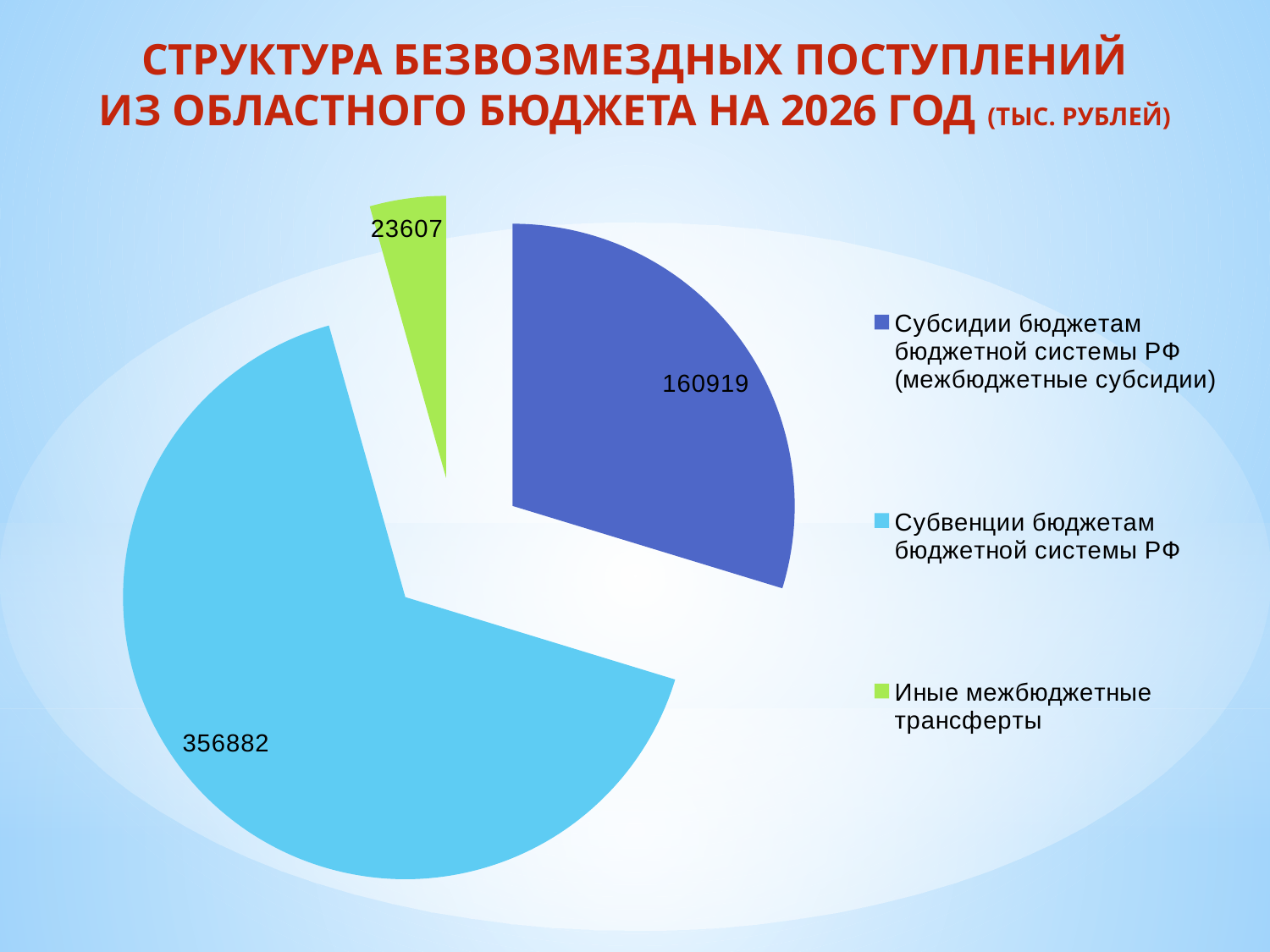
Which is larger: the value for Субсидии бюджетам бюджетной системы РФ (межбюджетные субсидии) or the value for Иные межбюджетные трансферты? Субсидии бюджетам бюджетной системы РФ (межбюджетные субсидии) Which category has the largest slice of the pie? Субвенции бюджетам бюджетной системы РФ What colour is the slice for Иные межбюджетные трансферты? Green What is the value for Субвенции бюджетам бюджетной системы РФ? 356882 What is the total of all three slices of the pie? 541408 What is the value for Иные межбюджетные трансферты? 23607 What is the value for Субсидии бюджетам бюджетной системы РФ (межбюджетные субсидии)? 160919 Which category has the smallest slice of the pie? Иные межбюджетные трансферты What is the difference between the values for Субвенции бюджетам бюджетной системы РФ and Субсидии бюджетам бюджетной системы РФ (межбюджетные субсидии)? 195963 What kind of chart is shown on the slide? Pie chart How many categories are shown in the pie chart? 3 What is the difference between the values for Субсидии бюджетам бюджетной системы РФ (межбюджетные субсидии) and Иные межбюджетные трансферты? 137312